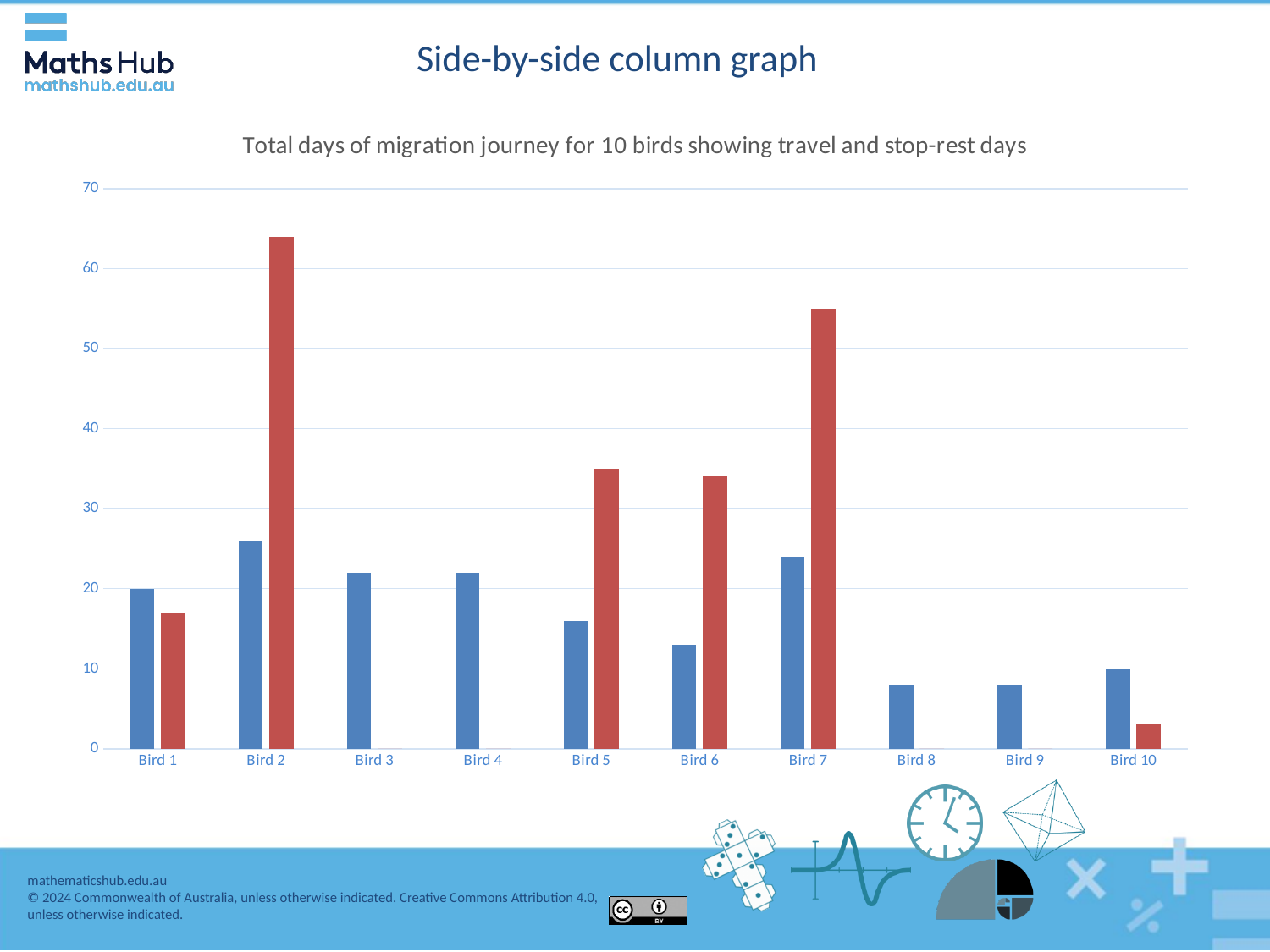
Is the red bar for Bird 7 greater or less than 50? greater Which bird has the tallest blue bar? Bird 2 How many birds (categories) are shown on the x axis? 10 What kind of chart is shown on the slide? bar chart What value does the blue bar for Bird 1 reach on the axis? 20 What is the title of the chart? Total days of migration journey for 10 birds showing travel and stop-rest days Which bird has the tallest red bar? Bird 2 Which is larger, the blue bar for Bird 6 or the blue bar for Bird 7? Bird 7 Is the red bar for Bird 2 greater or less than 60? greater Is the red bar for Bird 10 greater or less than 10? less Which is larger, the red bar for Bird 5 or the red bar for Bird 7? Bird 7